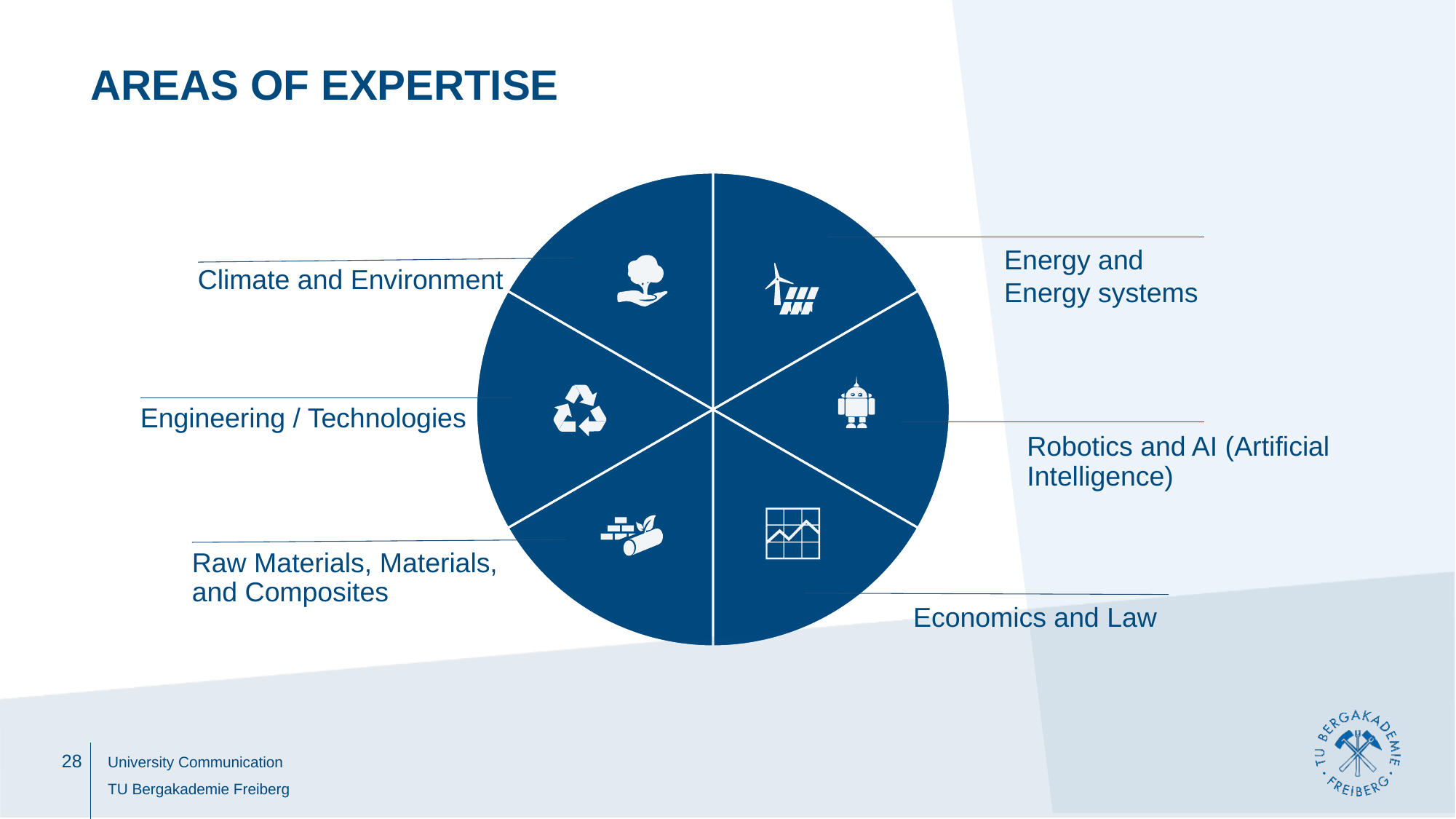
Which area of expertise is labelled at the top left of the circle, next to the tree-in-hand icon? Climate and Environment Which area of expertise is labelled next to the recycling icon? Engineering / Technologies How many segments does the circular diagram on the slide have? 6 What is the title of the slide containing the circular diagram? AREAS OF EXPERTISE Which area of expertise is labelled at the top right of the circle, next to the wind turbine and solar panel icon? Energy and Energy systems What kind of chart is used to show the areas of expertise? pie chart Which area of expertise is labelled next to the robot icon? Robotics and AI (Artificial Intelligence) Which area of expertise is labelled at the bottom right of the circle, next to the line-graph icon? Economics and Law Are the six segments of the circular diagram equal in size? yes Which area of expertise is labelled at the bottom left of the circle? Raw Materials, Materials, and Composites